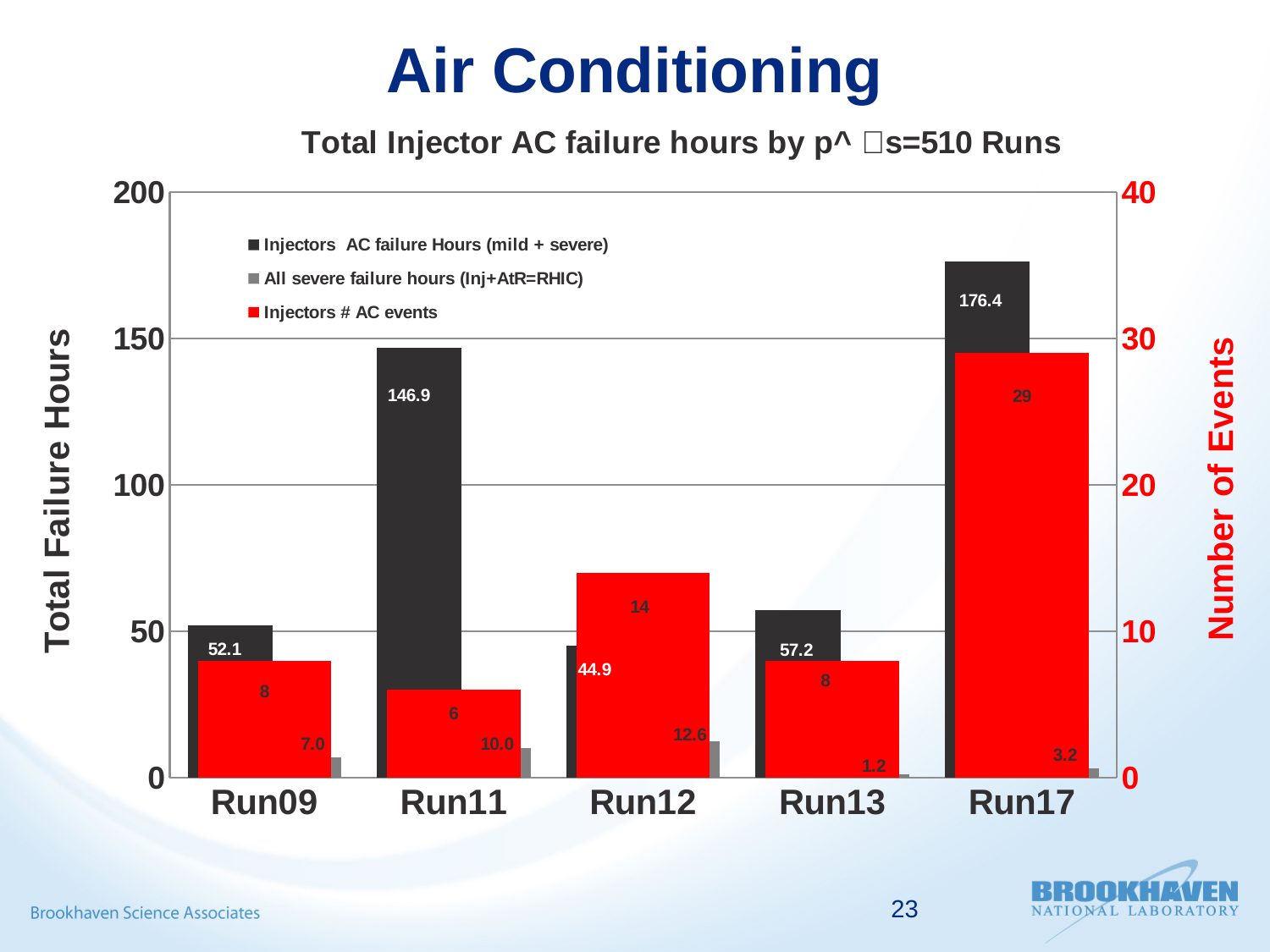
Which is larger, the All severe failure hours for Run12 or for Run09? Run12 What is the value of Injectors AC failure Hours (mild + severe) for Run11? 146.9 What is the value of All severe failure hours (Inj+AtR=RHIC) for Run13? 1.2 Which run has the lowest Injectors # AC events? Run11 What is the label of the right-hand vertical axis? Number of Events How many series does the legend list? 3 Is the Injectors AC failure Hours value for Run12 greater or less than 50? less Which run has the highest Injectors AC failure Hours (mild + severe)? Run17 What kind of chart is shown on the slide? bar chart How many runs are shown on the x axis? 5 What is the difference in Injectors AC failure Hours (mild + severe) between Run17 and Run11? 29.5 What is the value of Injectors # AC events for Run17? 29